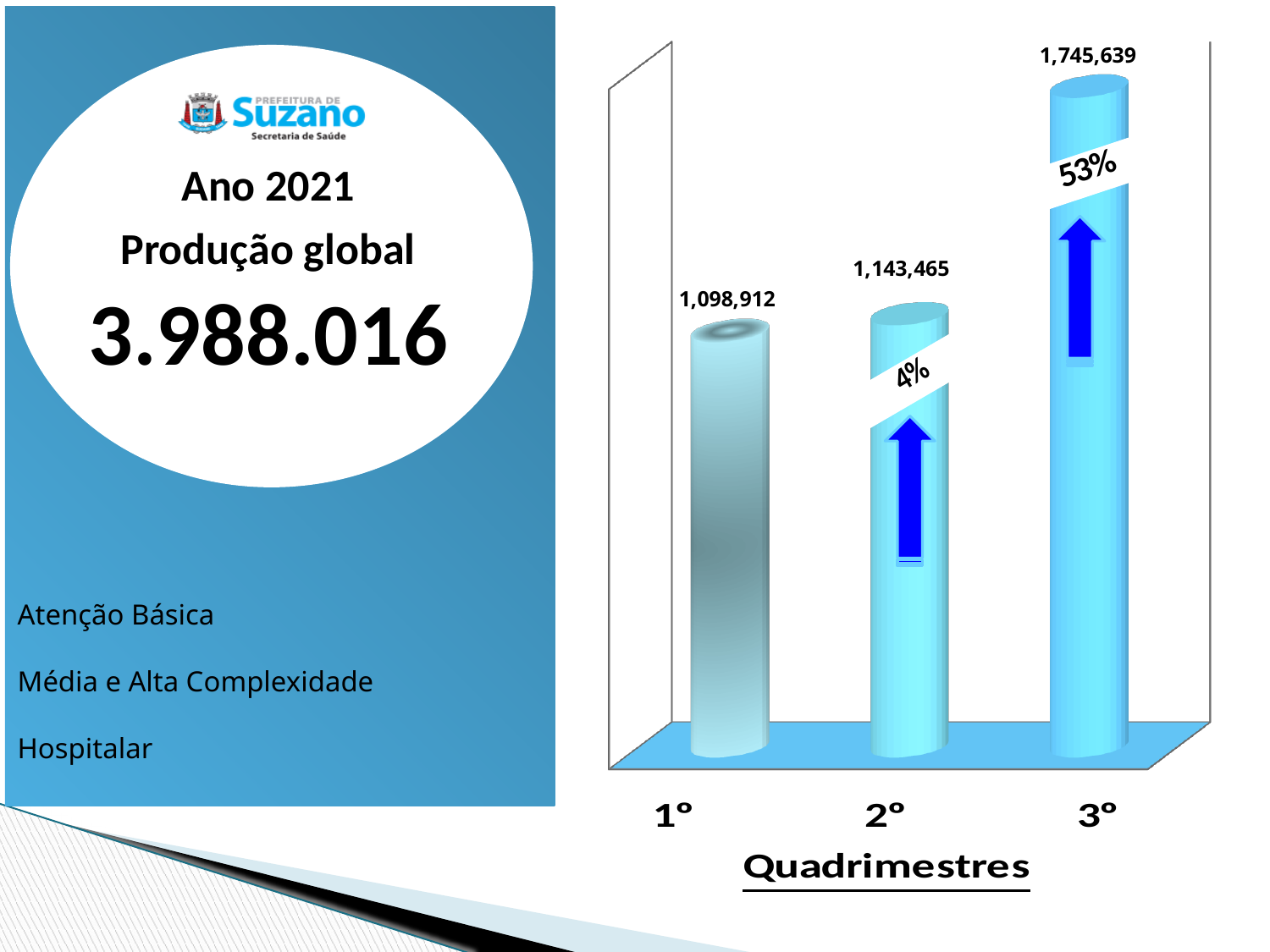
Which quadrimestre has the highest value? 3º What is the difference between the values for the 2º and 1º quadrimestres? 44,553 Which quadrimestre has the lowest value? 1º What is the value for the 1º quadrimestre? 1,098,912 Which is larger, the value for the 1º quadrimestre or the 2º quadrimestre? 2º How many quadrimestres are plotted on the chart? 3 What is the value for the 3º quadrimestre? 1,745,639 Do the values rise or fall from the 1º to the 3º quadrimestre? Rise What kind of chart is shown on the slide? Bar chart What is the value for the 2º quadrimestre? 1,143,465 What is the difference between the values for the 3º and 2º quadrimestres? 602,174 What percentage increase is labelled on the bar for the 3º quadrimestre? 53%